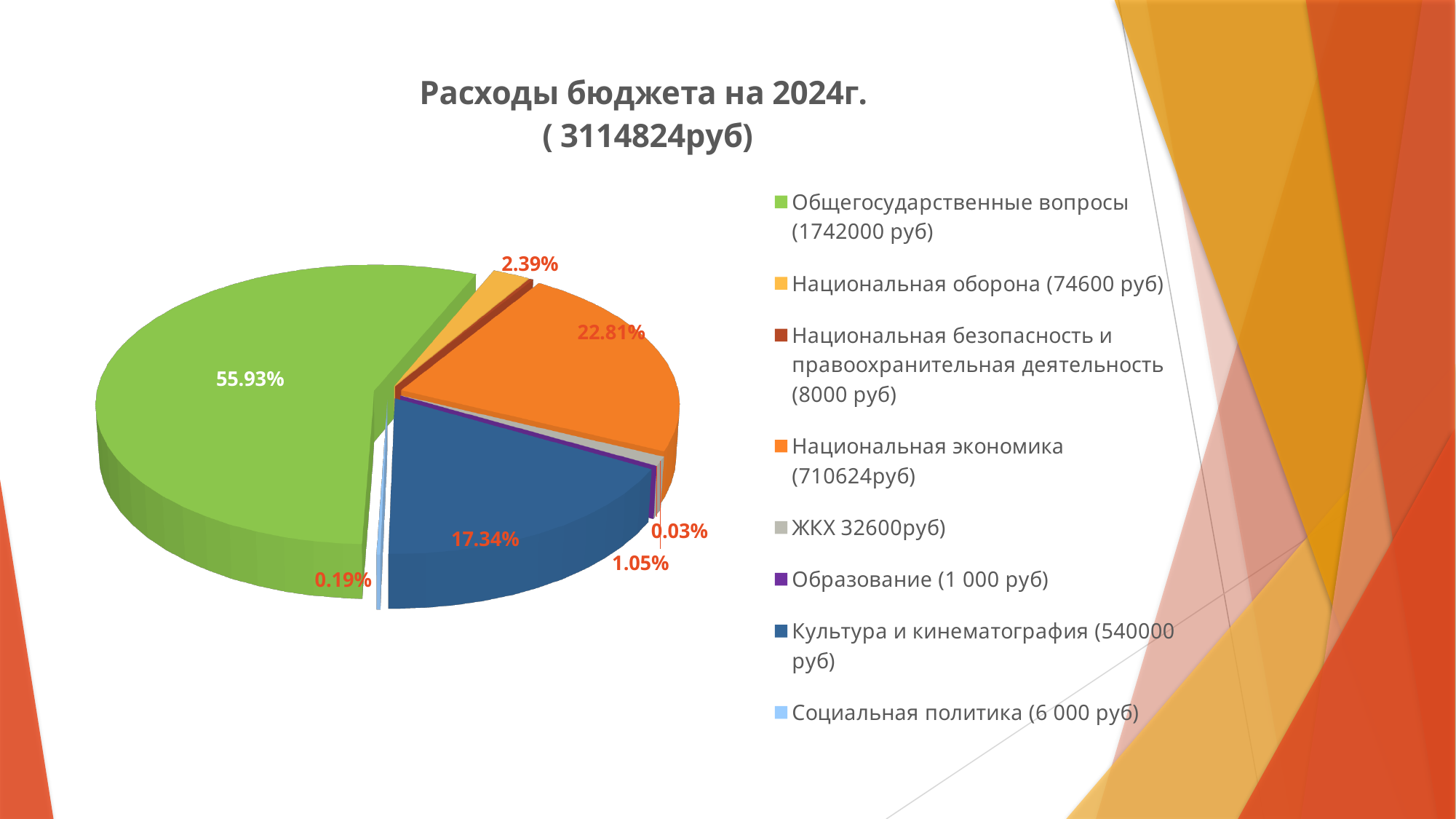
What percentage share is shown for Образование? 0.03% What percentage share is shown for Общегосударственные вопросы? 55.93% What percentage share is shown for Национальная экономика? 22.81% What kind of chart is shown on the slide? pie chart What percentage share is shown for Национальная оборона? 2.39% What is the difference in percentage points between the shares of Общегосударственные вопросы and Национальная экономика? 33.12 Which has the larger share: Национальная экономика or Культура и кинематография? Национальная экономика What percentage share is shown for Культура и кинематография? 17.34% How many categories does the legend list? 8 What is the title of the chart? Расходы бюджета на 2024г. ( 3114824руб) What amount in rubles does the legend give for Социальная политика? 6 000 руб Which category has the largest share of the pie? Общегосударственные вопросы